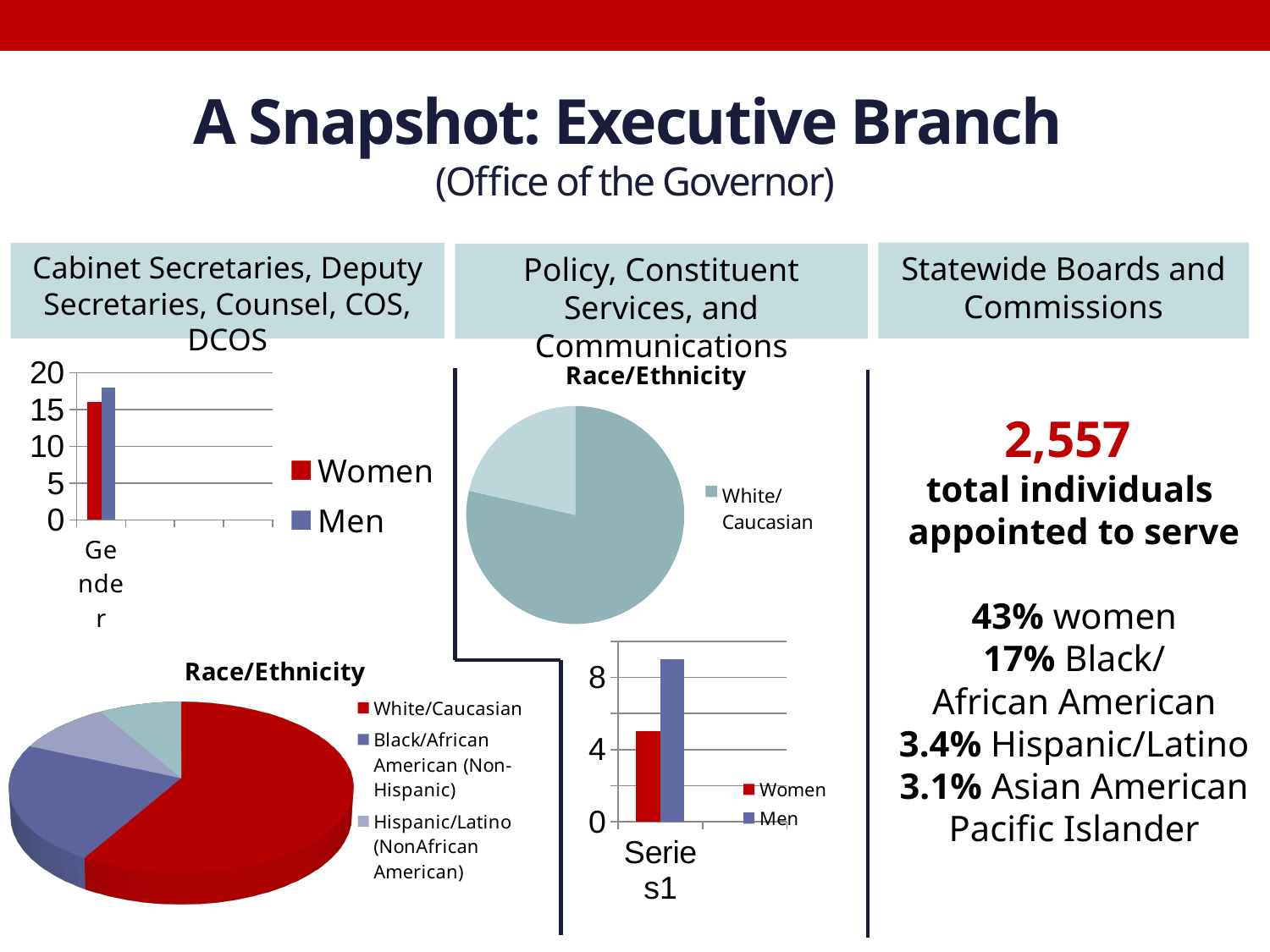
What kind of chart is the 'Race/Ethnicity' chart in the bottom-left of the slide? Pie chart In the bar chart under 'Policy, Constituent Services, and Communications', which is larger, the value for Women or the value for Men? Men In the bar chart under 'Policy, Constituent Services, and Communications', is the value for Men greater or less than 8? greater In the bottom-left 'Race/Ethnicity' pie chart, which category has the largest slice? White/Caucasian In the bottom-left 'Race/Ethnicity' pie chart, what colour is the White/Caucasian slice? Red In the bar chart under 'Cabinet Secretaries, Deputy Secretaries, Counsel, COS, DCOS', is the value for Men greater or less than 20? less In the bar chart under 'Cabinet Secretaries, Deputy Secretaries, Counsel, COS, DCOS', which is larger, the value for Women or the value for Men? Men In the bar chart under 'Policy, Constituent Services, and Communications', is the value for Women greater or less than 4? greater In the 'Race/Ethnicity' pie chart under 'Policy, Constituent Services, and Communications', which category has the largest slice? White/Caucasian How many series does the legend list in the bar chart under 'Cabinet Secretaries, Deputy Secretaries, Counsel, COS, DCOS'? 2 What kind of chart is the chart labelled 'Series1' under 'Policy, Constituent Services, and Communications'? Bar chart